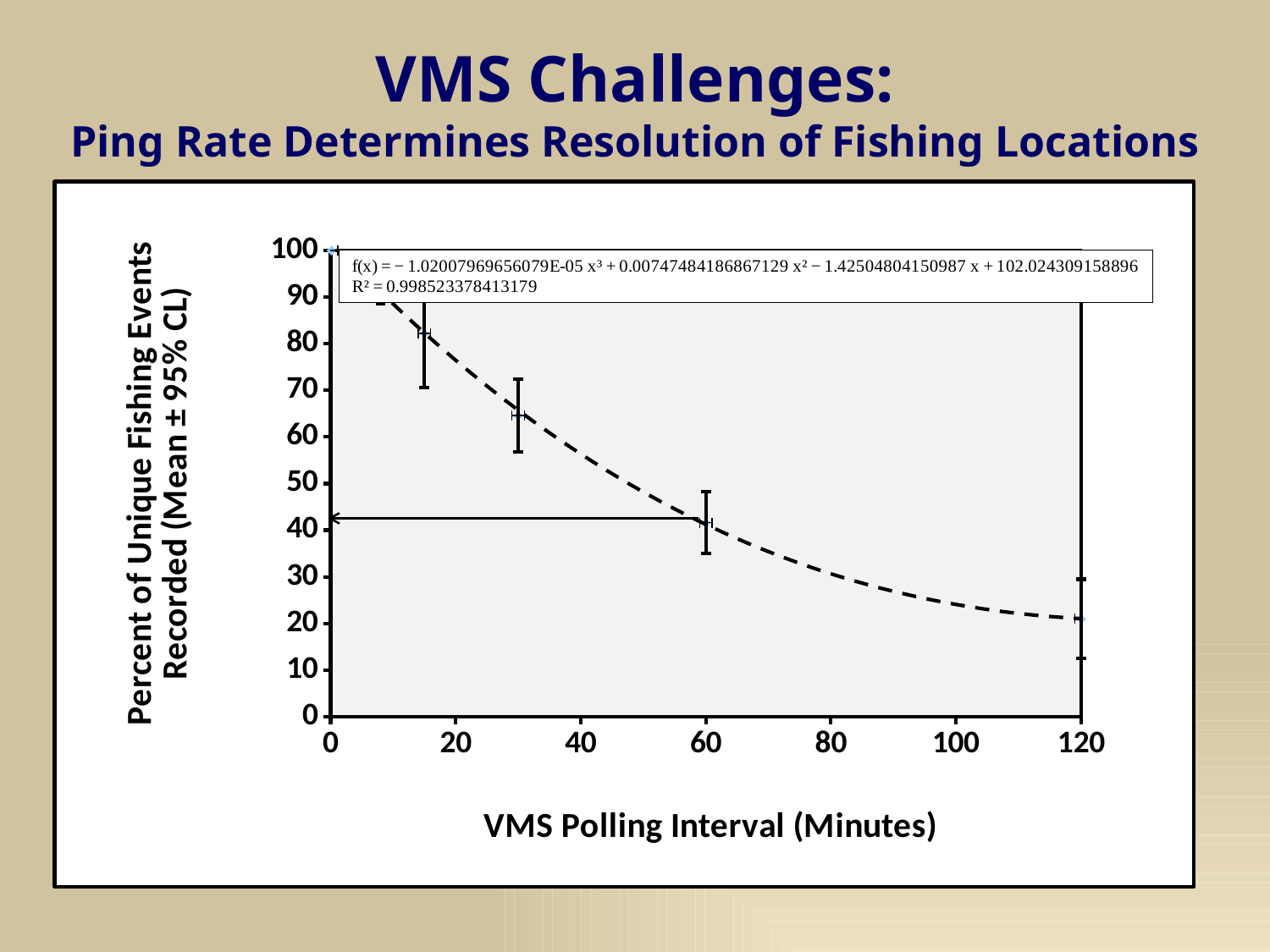
What R² value is printed on the chart for the fitted trendline? 0.998523378413179 Which has a higher percent of unique fishing events recorded: a polling interval of 15 minutes or 60 minutes? 15 minutes Is the value at a polling interval of 120 minutes greater or less than 30? less At which VMS polling interval is the percent of unique fishing events recorded highest? 0 At which VMS polling interval is the percent of unique fishing events recorded lowest? 120 What is the percent of unique fishing events recorded at a polling interval of 0 minutes? 100 Is the value at a polling interval of 15 minutes greater or less than 70? greater Is the value at a polling interval of 60 minutes greater or less than 50? less What kind of chart is shown on the slide? scatter chart Do the plotted values rise or fall as the VMS polling interval increases? fall What is the title of the x axis of the chart? VMS Polling Interval (Minutes)